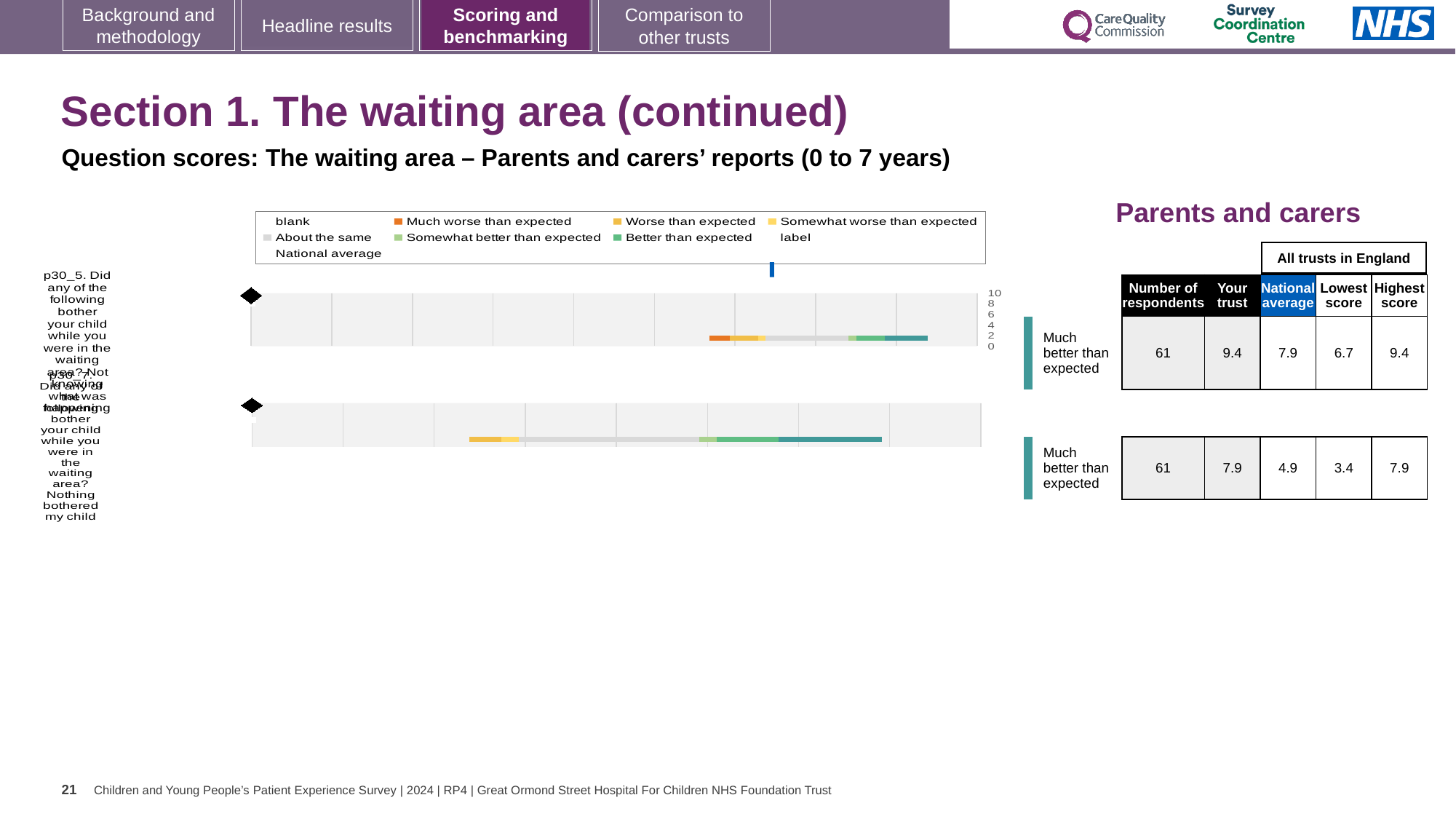
In the table beside the chart, what is the 'Your trust' score for the first question (p30_5)? 9.4 What is the lowest score across all trusts in England for question p30_7? 3.4 In the table beside the chart, what is the national average for the second question (p30_7)? 4.9 What benchmark category is shown next to both bars in the chart? Much better than expected By how much does the trust's score for p30_5 exceed the national average for that question? 1.5 What is the maximum value shown on the chart's score axis? 10 How many questions (bars) are plotted in the chart? 2 How many respondents answered question p30_5 according to the table? 61 What is the difference between the highest and lowest trust scores for question p30_7? 4.5 Which question has the higher 'Your trust' score, p30_5 or p30_7? p30_5 Which colour does the legend use for 'Much worse than expected'? Orange What kind of chart is used to show the question scores for the waiting area? Bar chart